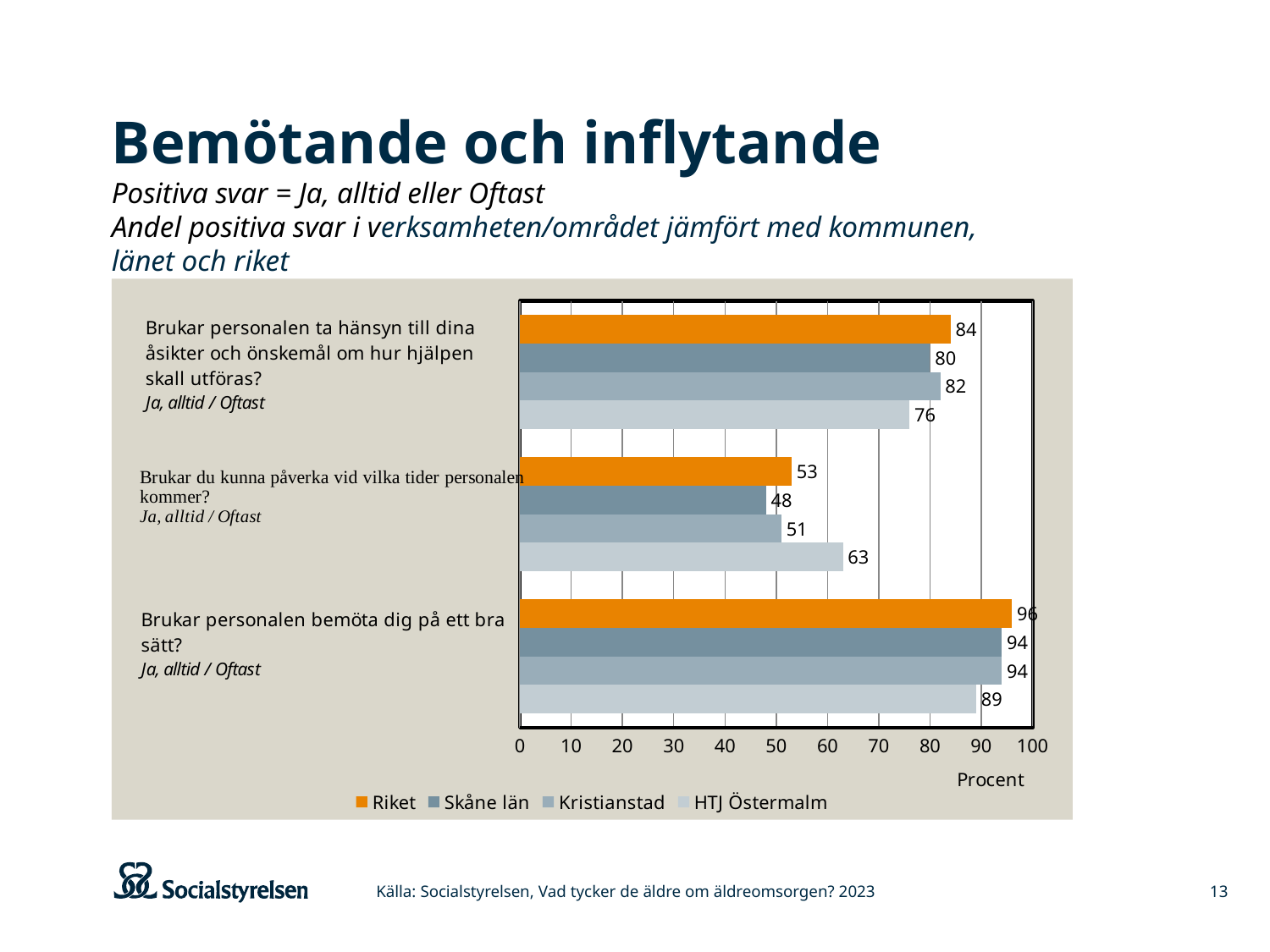
What label is shown on the horizontal axis of the chart? Procent What is the difference between Riket and HTJ Östermalm on the question "Brukar personalen bemöta dig på ett bra sätt?"? 7 What is the value for HTJ Östermalm on the question "Brukar du kunna påverka vid vilka tider personalen kommer?"? 63 Which series has the highest value on the question "Brukar du kunna påverka vid vilka tider personalen kommer?"? HTJ Östermalm Which series is shown in orange in the chart? Riket Which series has the lowest value on the question "Brukar personalen ta hänsyn till dina åsikter och önskemål om hur hjälpen skall utföras?"? HTJ Östermalm How many series does the legend list? 4 How many question categories are plotted in the chart? 3 What kind of chart is shown on the slide? Bar chart What is the value for Skåne län on the question "Brukar personalen bemöta dig på ett bra sätt?"? 94 What is the value for Riket on the question "Brukar personalen ta hänsyn till dina åsikter och önskemål om hur hjälpen skall utföras?"? 84 Which is larger on the question "Brukar du kunna påverka vid vilka tider personalen kommer?": Riket or Skåne län? Riket